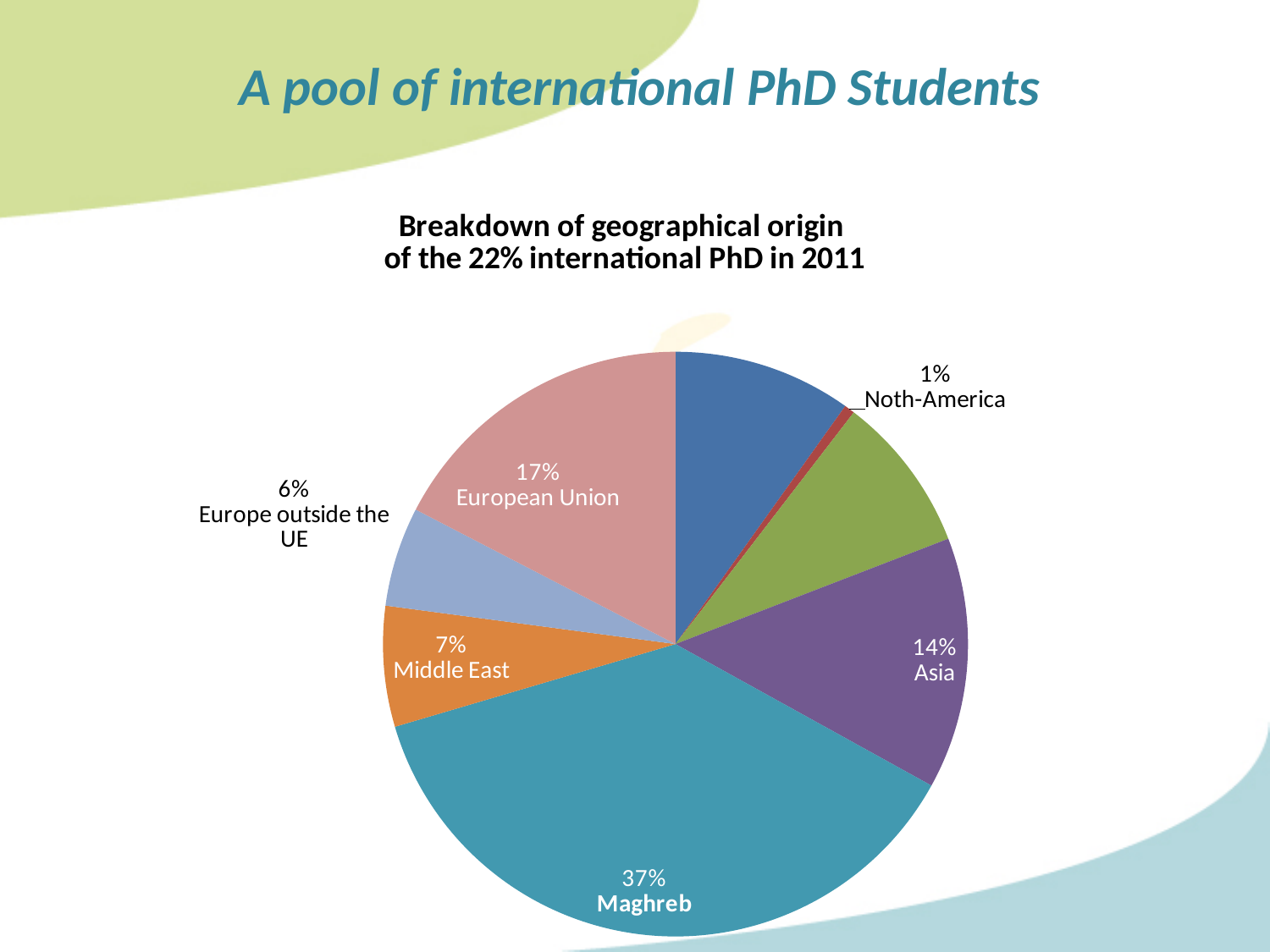
What percentage is shown for the European Union slice? 17% What kind of chart is shown on the slide? pie chart What percentage is shown for Asia? 14% What percentage is shown for Noth-America? 1% What percentage is shown for the Middle East? 7% What is the title of the pie chart? Breakdown of geographical origin of the 22% international PhD in 2011 Which labelled region has the smallest slice of the pie? Noth-America What percentage is shown for Europe outside the UE? 6% Which slice is larger, Asia or Middle East? Asia What share of the pie does Maghreb account for? 37% How many percentage points larger is the Maghreb share than the European Union share? 20 Which labelled region has the largest slice of the pie? Maghreb